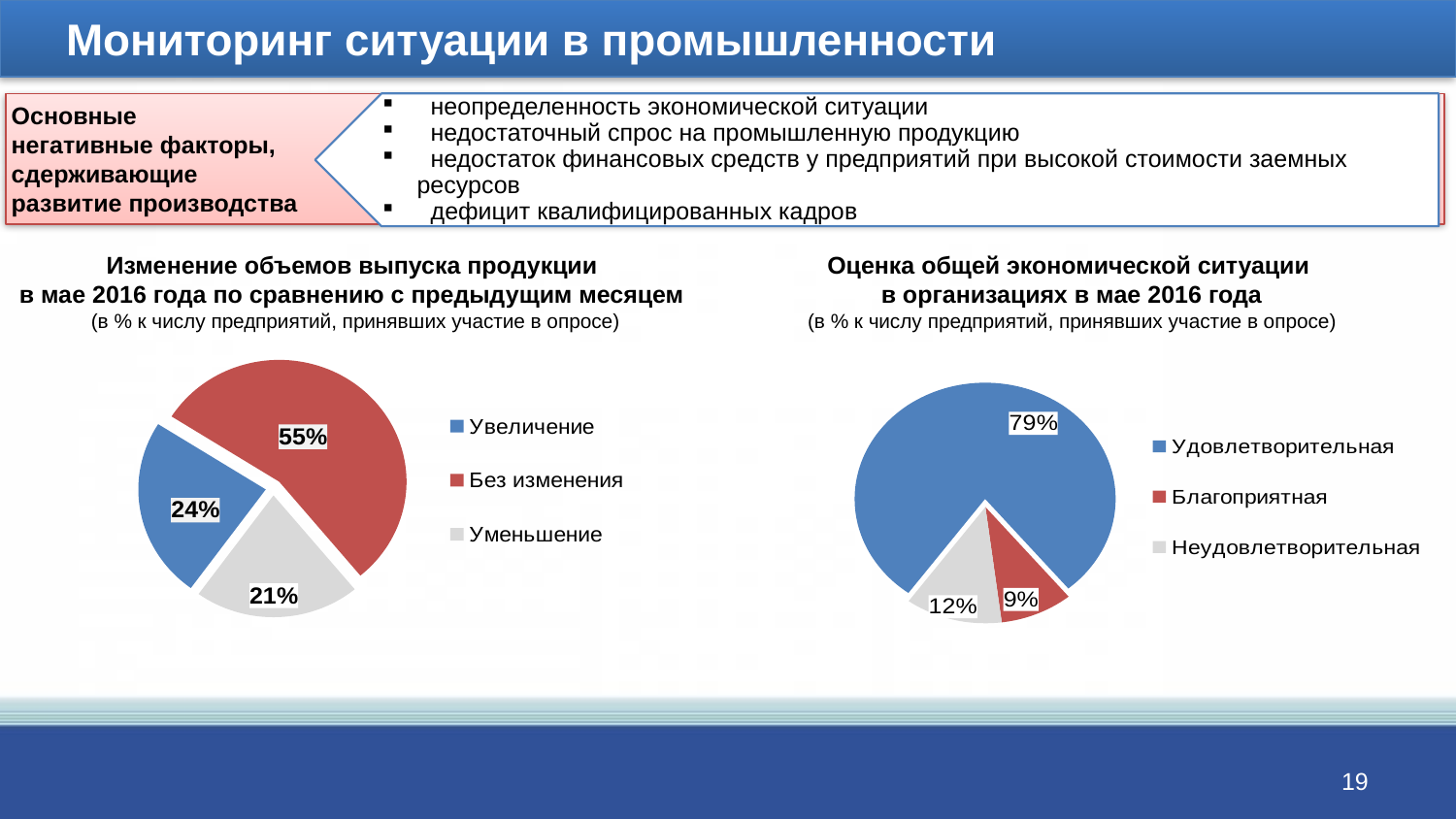
In the left chart (Изменение объемов выпуска продукции), which is larger: 'Увеличение' or 'Уменьшение'? Увеличение In the left chart (Изменение объемов выпуска продукции), what share of enterprises reported 'Увеличение'? 24% In the right chart (Оценка общей экономической ситуации), what colour is the 'Благоприятная' slice? Red How many categories does the right chart (Оценка общей экономической ситуации) show? 3 In the right chart (Оценка общей экономической ситуации), what is the difference between the 'Неудовлетворительная' and 'Благоприятная' shares? 3 percentage points In the left chart (Изменение объемов выпуска продукции), which category has the smallest slice? Уменьшение What type of chart is the left chart (Изменение объемов выпуска продукции)? Pie chart In the left chart (Изменение объемов выпуска продукции), what is the difference between the 'Без изменения' and 'Уменьшение' shares? 34 percentage points In the right chart (Оценка общей экономической ситуации), what share of organizations rated the situation 'Благоприятная'? 9% In the left chart (Изменение объемов выпуска продукции), what share of enterprises reported 'Без изменения'? 55% In the right chart (Оценка общей экономической ситуации), what share of organizations rated the situation 'Удовлетворительная'? 79% In the right chart (Оценка общей экономической ситуации), which category has the largest slice? Удовлетворительная